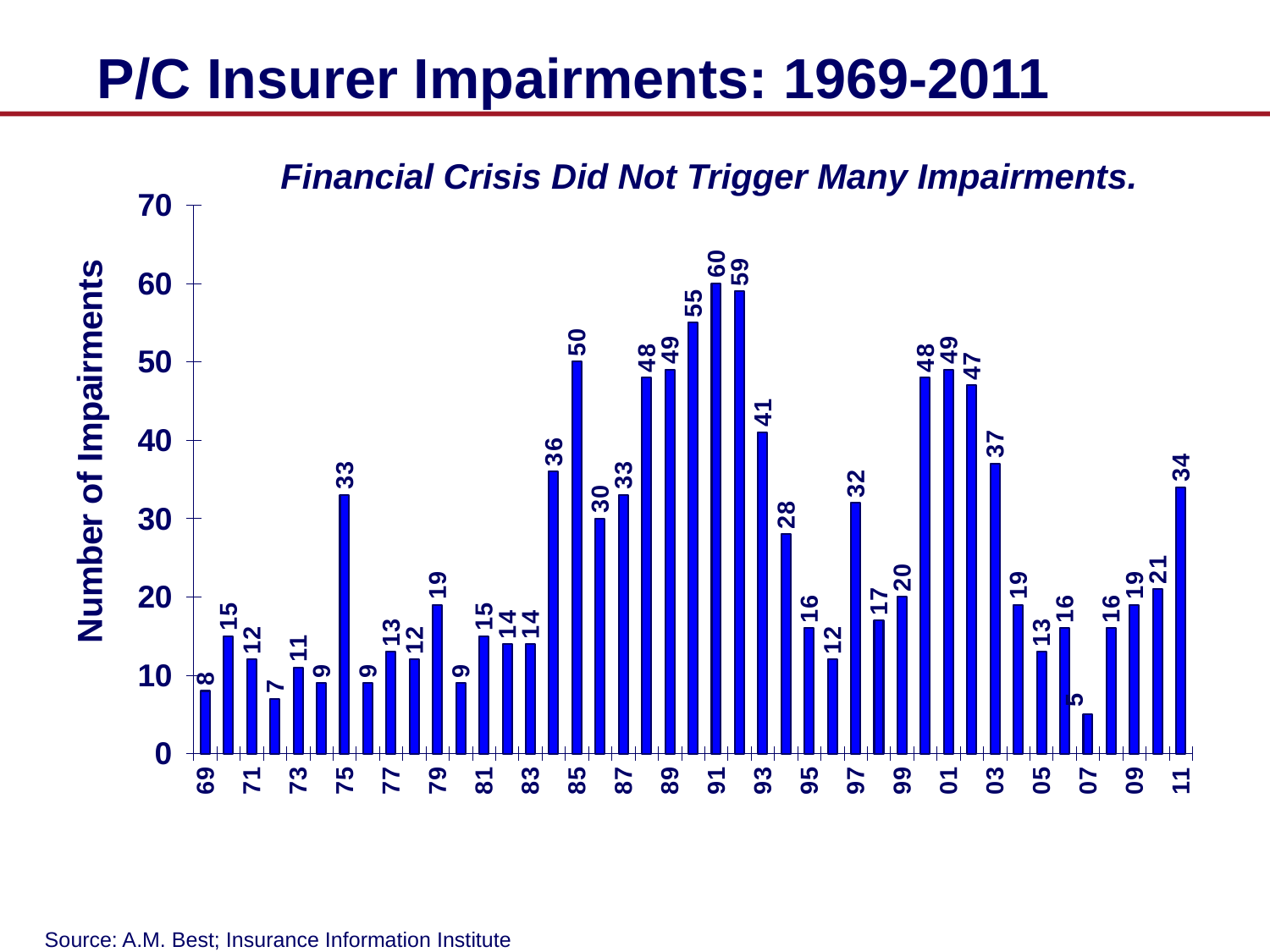
How many impairments were there in 1975? 33 Which year had the highest number of impairments? 1991 How many impairments were there in 2011? 34 Which year had more impairments, 2003 or 1997? 2003 What is the subtitle shown above the chart? Financial Crisis Did Not Trigger Many Impairments. How many years (bars) are plotted in the chart? 43 What is the difference between the number of impairments in 1985 and in 1995? 34 What type of chart is shown on the slide? bar chart What is the label on the vertical axis? Number of Impairments Which year had the lowest number of impairments? 2007 How many impairments were there in 1991? 60 Is the number of impairments in 1989 greater or less than 40? greater